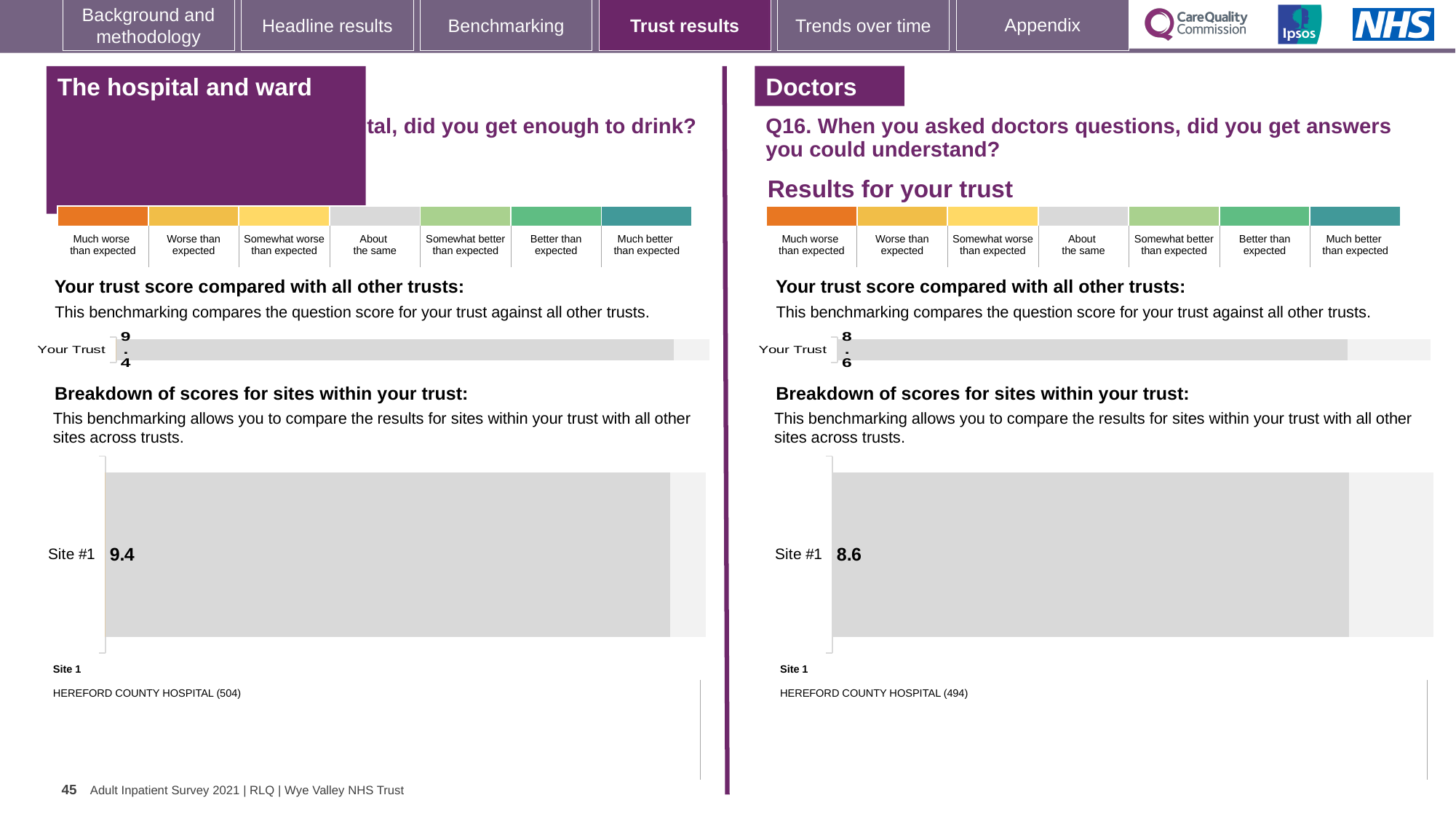
In the right-hand 'Your trust score compared with all other trusts' chart for Q16 (Doctors), what is the score shown for Your Trust? 8.6 What kind of chart is used to show the Your Trust score in the left-hand 'Your trust score compared with all other trusts' section? Bar chart How many sites are shown in the right-hand 'Breakdown of scores for sites within your trust' chart for Q16? 1 In the right-hand 'Breakdown of scores for sites within your trust' chart for Q16, what is the score for Site #1? 8.6 Which is higher: the Your Trust score in the left-hand chart (hospital and ward question) or the Your Trust score in the right-hand chart (Q16, Doctors)? The left-hand chart (9.4) In the left-hand 'Breakdown of scores for sites within your trust' chart, what is the score for Site #1? 9.4 In the left-hand site breakdown chart, is the score for Site #1 greater or less than 9? greater In the left-hand 'Your trust score compared with all other trusts' chart (The hospital and ward section), what is the score shown for Your Trust? 9.4 What is the difference between the Your Trust score in the left-hand chart (9.4) and the Your Trust score in the right-hand Q16 chart (8.6)? 0.8 Which hospital is listed as Site 1 beneath the right-hand site breakdown chart for Q16? HEREFORD COUNTY HOSPITAL What number appears in parentheses after HEREFORD COUNTY HOSPITAL beneath the left-hand site breakdown chart? 504